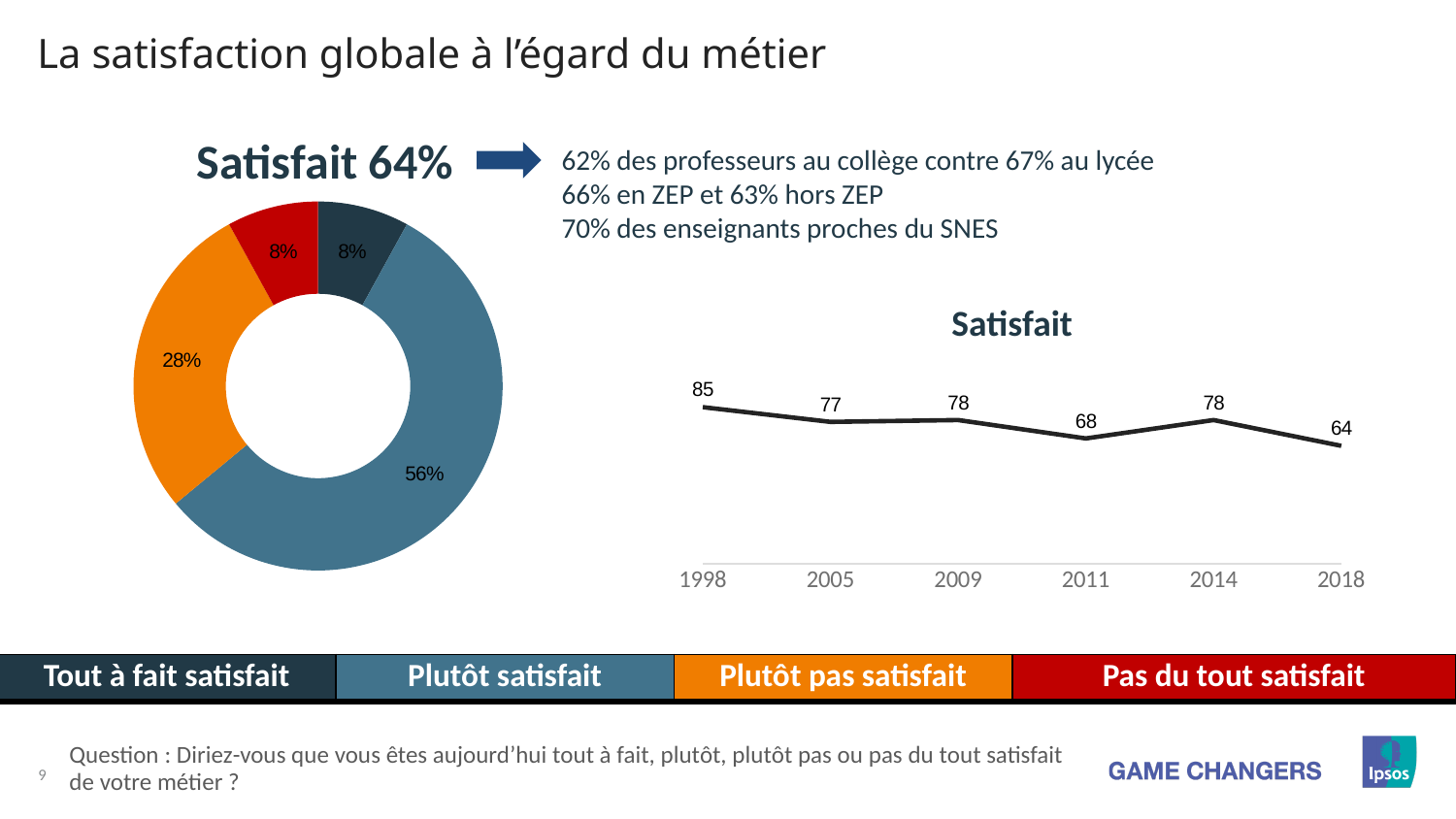
In the line chart titled "Satisfait", what is the value for 1998? 85 What kind of chart is the chart on the left of the slide? pie chart (donut) How many categories does the legend bar at the bottom of the slide list? 4 In the line chart titled "Satisfait", how many years are plotted on the x axis? 6 In the line chart titled "Satisfait", which year has the highest value? 1998 In the donut chart on the left, what share is shown for "Plutôt satisfait"? 56% In the line chart titled "Satisfait", what is the value for 2018? 64 In the line chart titled "Satisfait", does the value rise or fall from 2014 to 2018? fall In the line chart titled "Satisfait", what is the difference between the values for 1998 and 2018? 21 In the line chart titled "Satisfait", which year has the lowest value? 2018 In the line chart titled "Satisfait", which is larger, the value for 2011 or the value for 2014? 2014 In the donut chart on the left, what share is shown for "Plutôt pas satisfait"? 28%